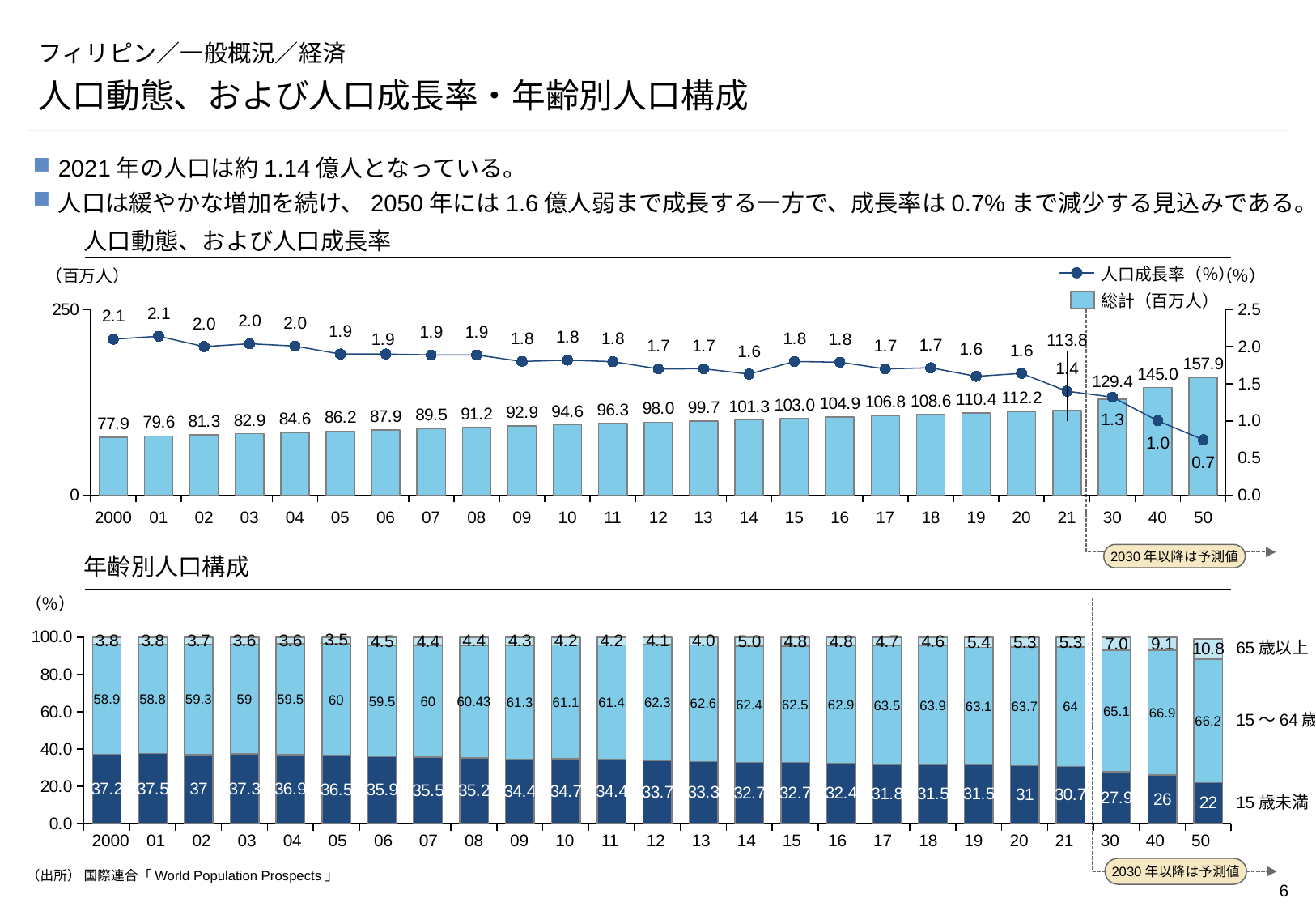
In the top chart (人口動態、および人口成長率), what is the total population (総計) shown for 2021? 113.8 In the top chart (人口動態、および人口成長率), how much larger is the total population in 2050 than in 2000? 80.0 In the top chart (人口動態、および人口成長率), which year has the lowest population growth rate? 50 (2050) What kind of chart is the bottom chart (年齢別人口構成)? stacked bar chart In the top chart (人口動態、および人口成長率), how many years are shown on the x axis? 25 In the bottom chart (年齢別人口構成), what is the share of 15歳未満 in 2000? 37.2 In the top chart (人口動態、および人口成長率), how many series does the legend list? 2 In the bottom chart (年齢別人口構成), is the share of 15歳未満 larger in 2000 or in 2050? 2000 In the top chart (人口動態、および人口成長率), which year has the highest total population bar? 50 (2050) In the bottom chart (年齢別人口構成), what is the share of 65歳以上 in 2050? 10.8 In the top chart (人口動態、および人口成長率), does the population growth rate line generally rise or fall from 2000 to 2050? fall In the top chart (人口動態、および人口成長率), what is the population growth rate (人口成長率) shown for 2050? 0.7